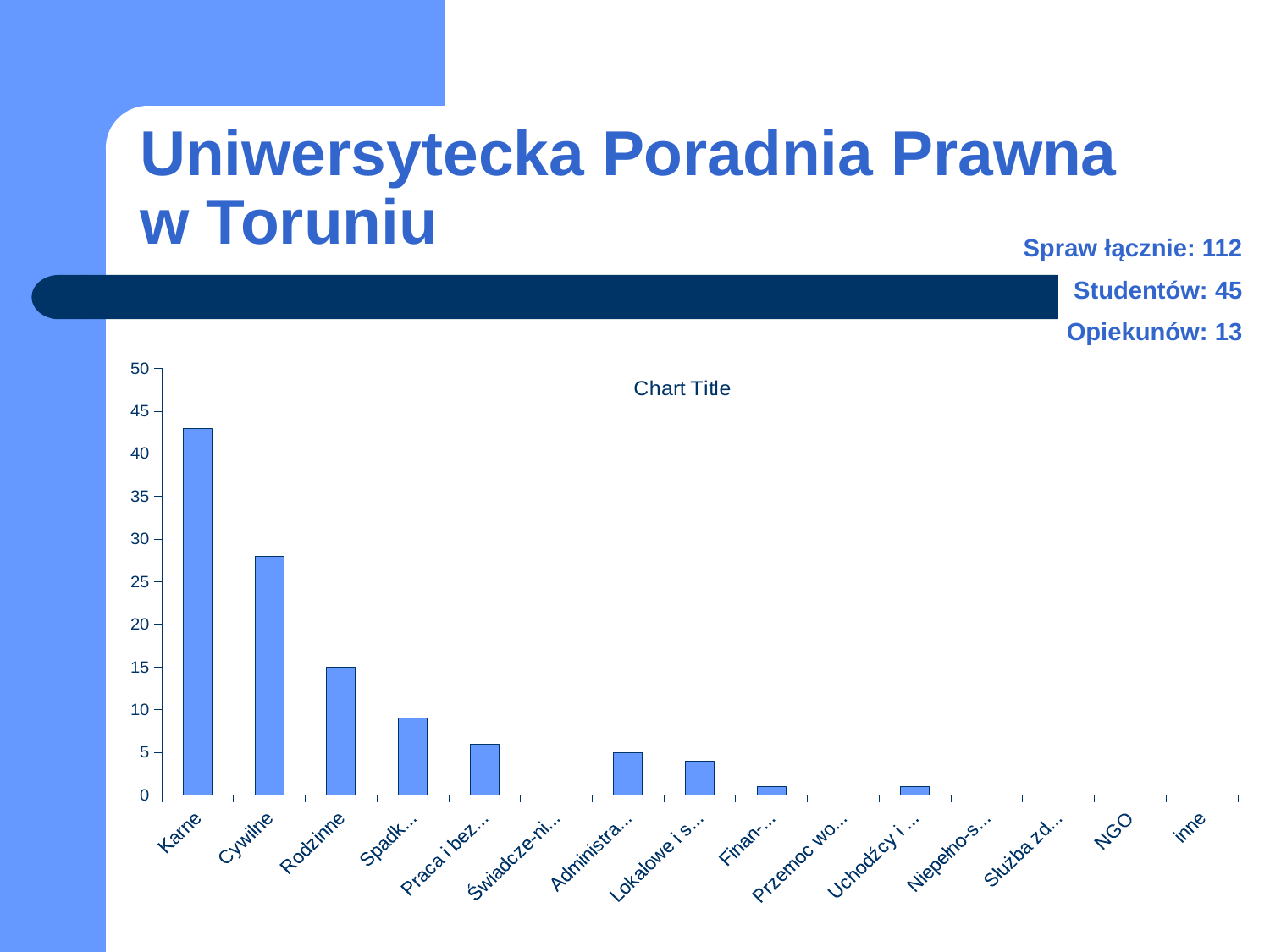
Do the values generally rise or fall from left to right along the x axis? fall What title is displayed on the chart? Chart Title What kind of chart is shown on the slide? bar chart What is the value for Rodzinne? 15 Which category has the highest value in the chart? Karne Which is larger, the value for Rodzinne or the value for Praca i bez...? Rodzinne Is the value for Karne greater or less than 40? greater Which is larger, the value for Karne or the value for Cywilne? Karne Is the value for Cywilne greater or less than 25? greater How many categories are shown on the x axis of the chart? 15 Is the value for Spadk... greater or less than 10? less